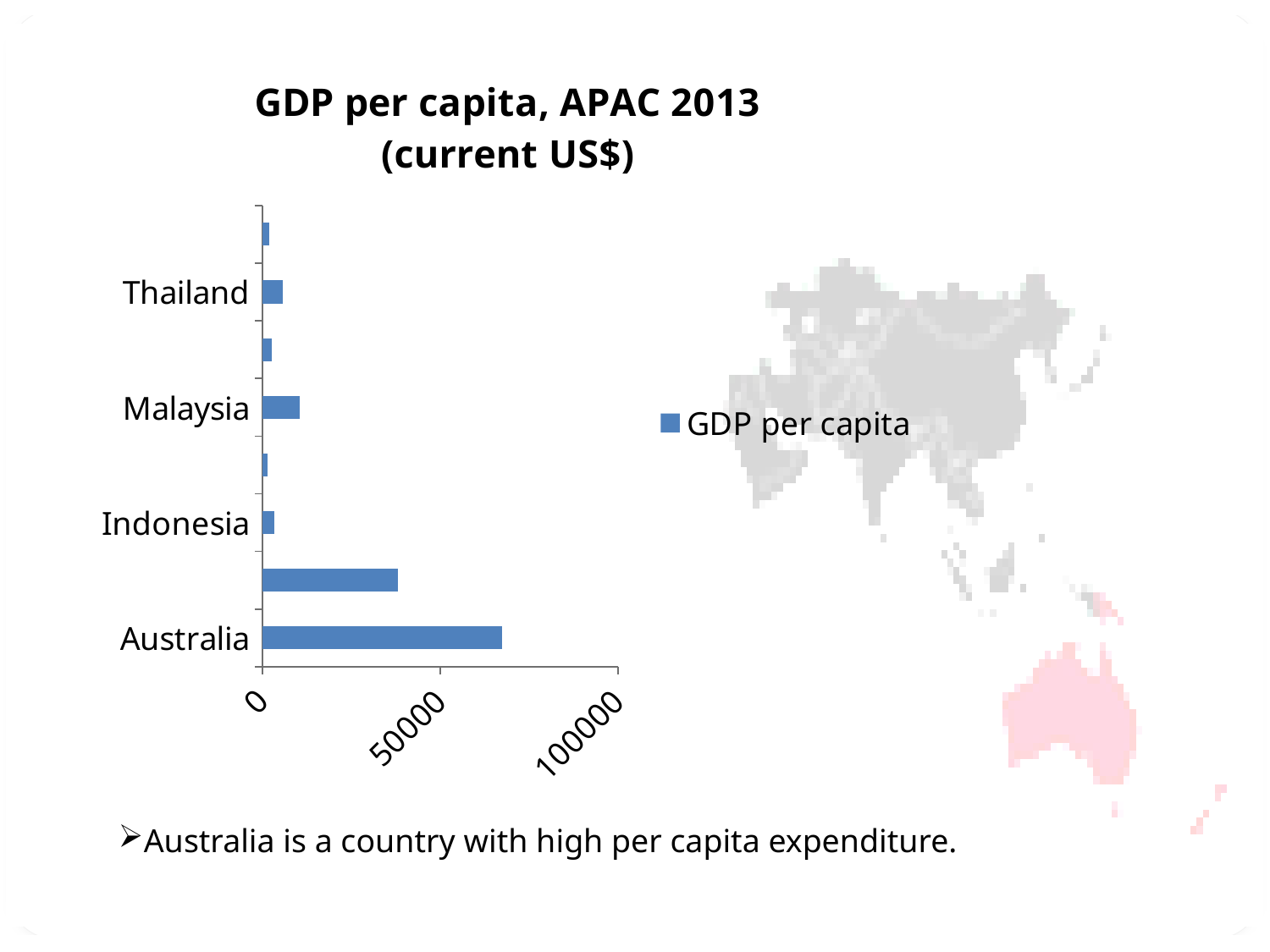
Which of the labelled countries has the lowest GDP per capita? Indonesia Which has a higher GDP per capita, Malaysia or Indonesia? Malaysia Which has a higher GDP per capita, Australia or Thailand? Australia Is the value for Australia greater or less than 50000? greater How many bars are plotted in the chart? 8 Which of the labelled countries has the highest GDP per capita? Australia What is the name of the series shown in the legend? GDP per capita What is the title of the chart? GDP per capita, APAC 2013 (current US$) What kind of chart is shown on the slide? bar chart Is the value for Malaysia greater or less than 50000? less How many series does the legend list? 1 Is the value for Thailand greater or less than 50000? less